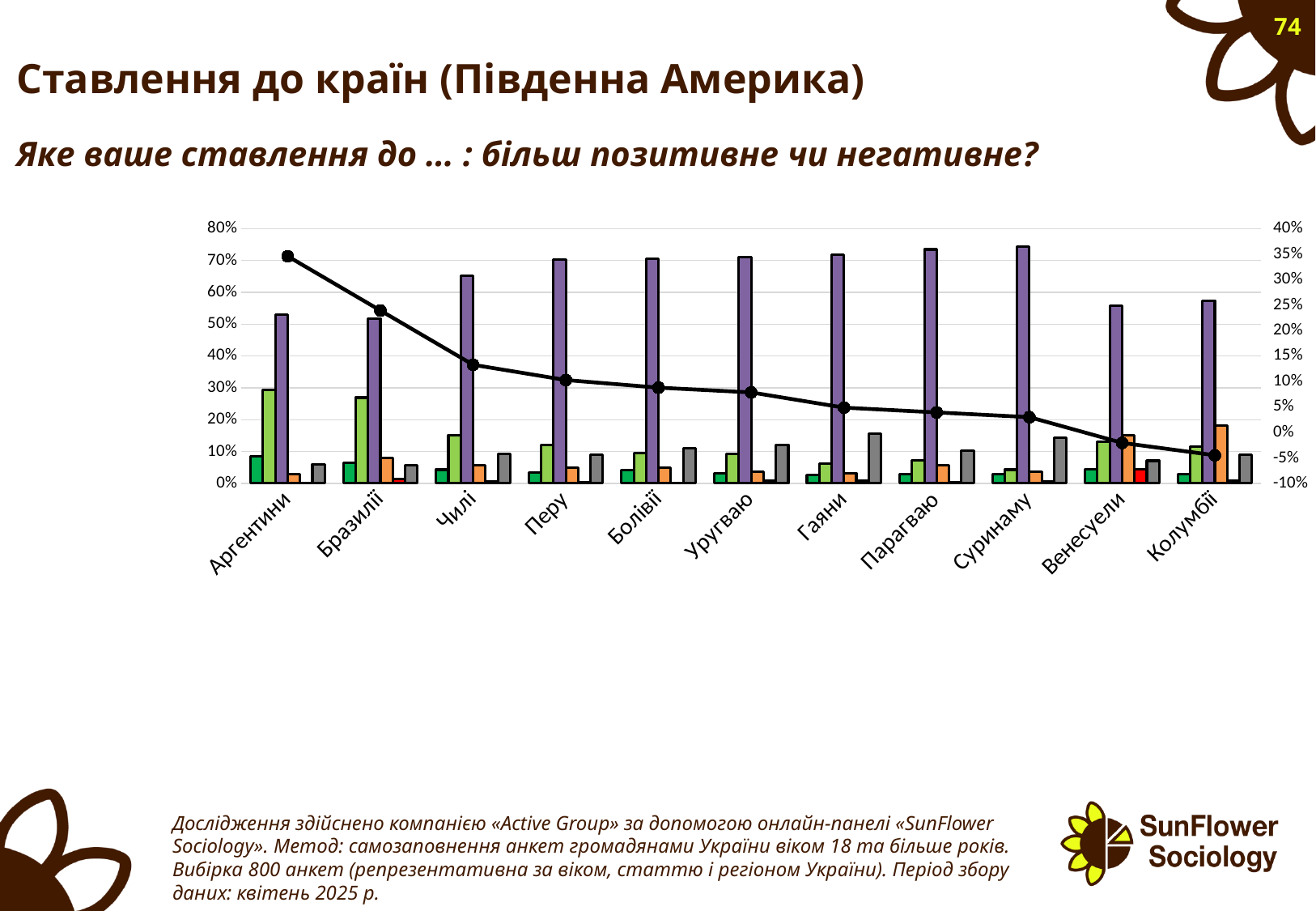
How many countries are shown along the x axis of the chart? 11 Which is taller: the light green bar for Аргентини or the light green bar for Чилі? Аргентини For which country is the black line at its lowest point? Колумбії What kind of chart is shown on the slide? A combined bar and line chart Does the black line rise or fall from Аргентини to Колумбії? It falls Is the black line point for Колумбії greater or less than 0% on the right axis? less Which is taller: the purple bar for Суринаму or the purple bar for Аргентини? Суринаму Is the purple bar for Перу greater or less than 60% on the left axis? greater Is the light green bar for Аргентини greater or less than 20% on the left axis? greater For which country is the black line at its highest point? Аргентини Which country has the tallest purple bar? Суринаму